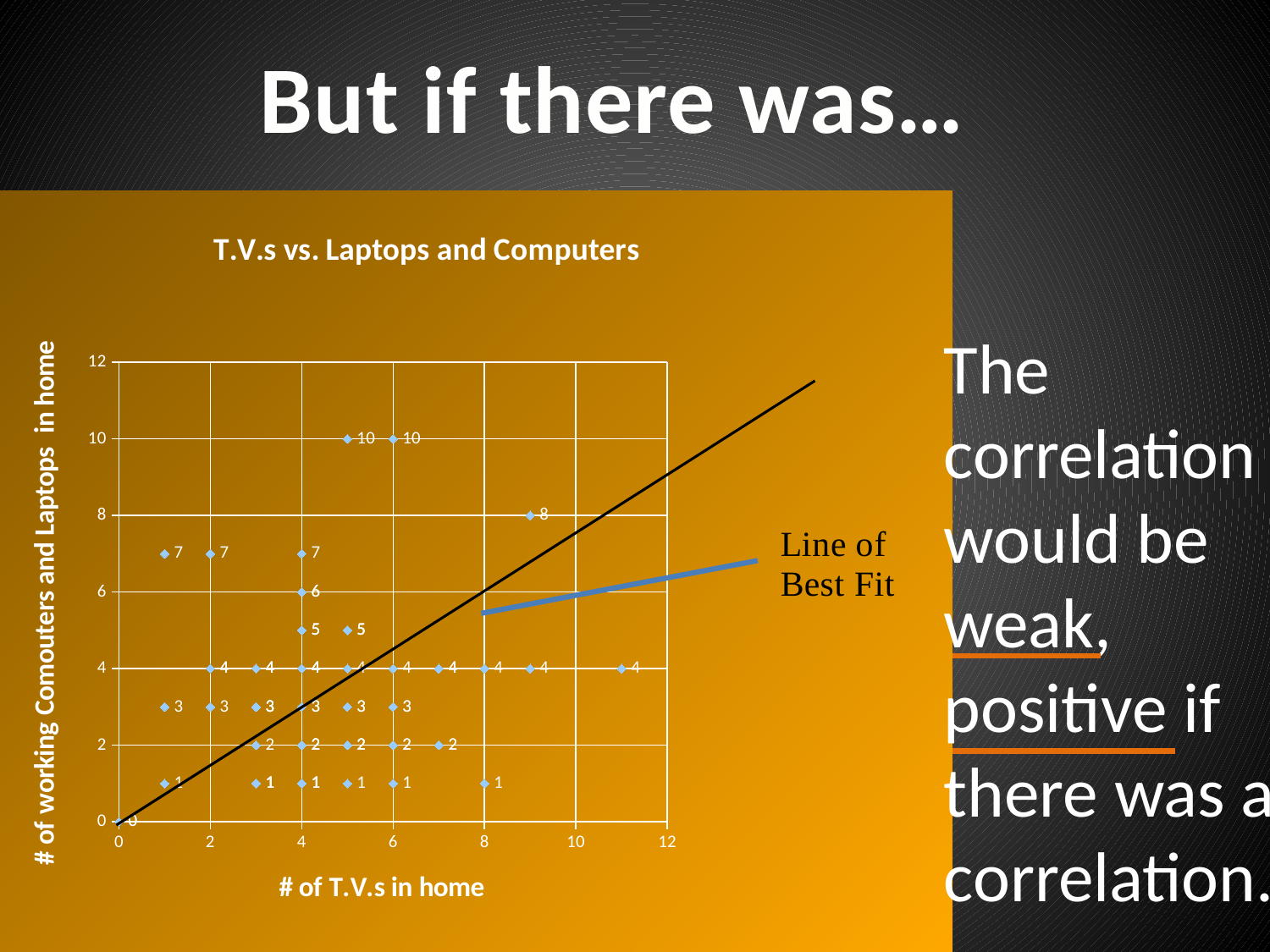
What is the y value of the point plotted at 11 T.V.s in home? 4 What is the maximum value shown on the x axis? 12 Does the line of best fit rise or fall as the number of T.V.s increases? rise What is the highest y value plotted on the chart? 10 Is the y value of the point at 11 T.V.s greater or less than 6? less What is the lowest y value plotted on the chart? 0 What is the title of the x axis of the chart? # of T.V.s in home What is the title of the chart? T.V.s vs. Laptops and Computers What kind of chart is shown on the slide? scatter chart